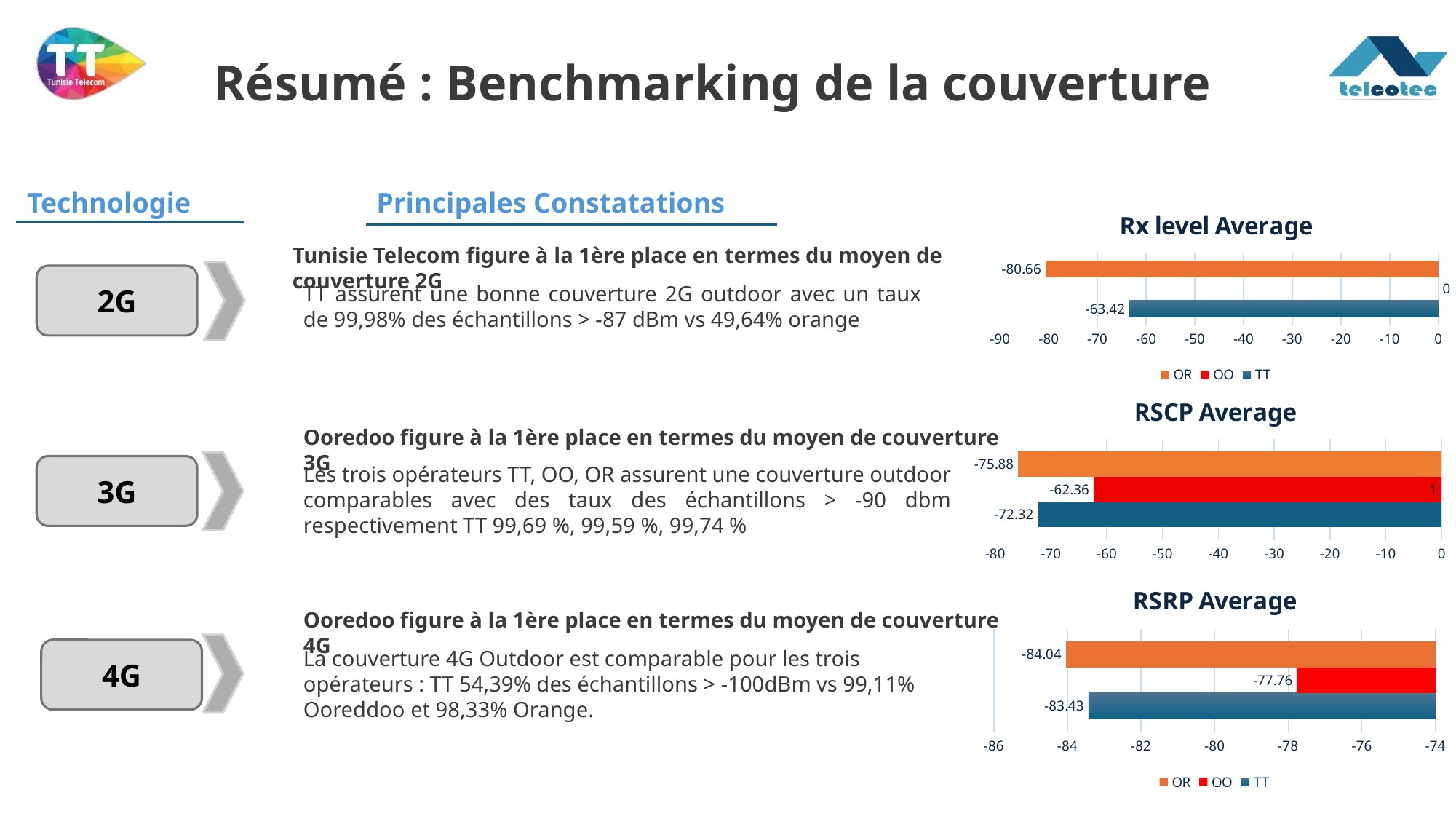
In the RSRP Average chart, what is the value for TT? -83.43 In the Rx level Average chart, what is the difference between the TT value and the OR value? 17.24 How many series does the legend of the Rx level Average chart list? 3 In the RSRP Average chart, what is the difference between the OO value and the OR value? 6.28 In the RSCP Average chart, which operator has the highest value? OO In the RSCP Average chart, what is the value for OR? -75.88 What kind of chart is the Rx level Average chart? bar chart In the Rx level Average chart, what is the value for OR? -80.66 In the Rx level Average chart, what is the value for TT? -63.42 In the RSRP Average chart, which operator has the lowest value? OR In the RSCP Average chart, what is the difference between the TT value and the OR value? 3.56 In the RSCP Average chart, what is the value for OO? -62.36